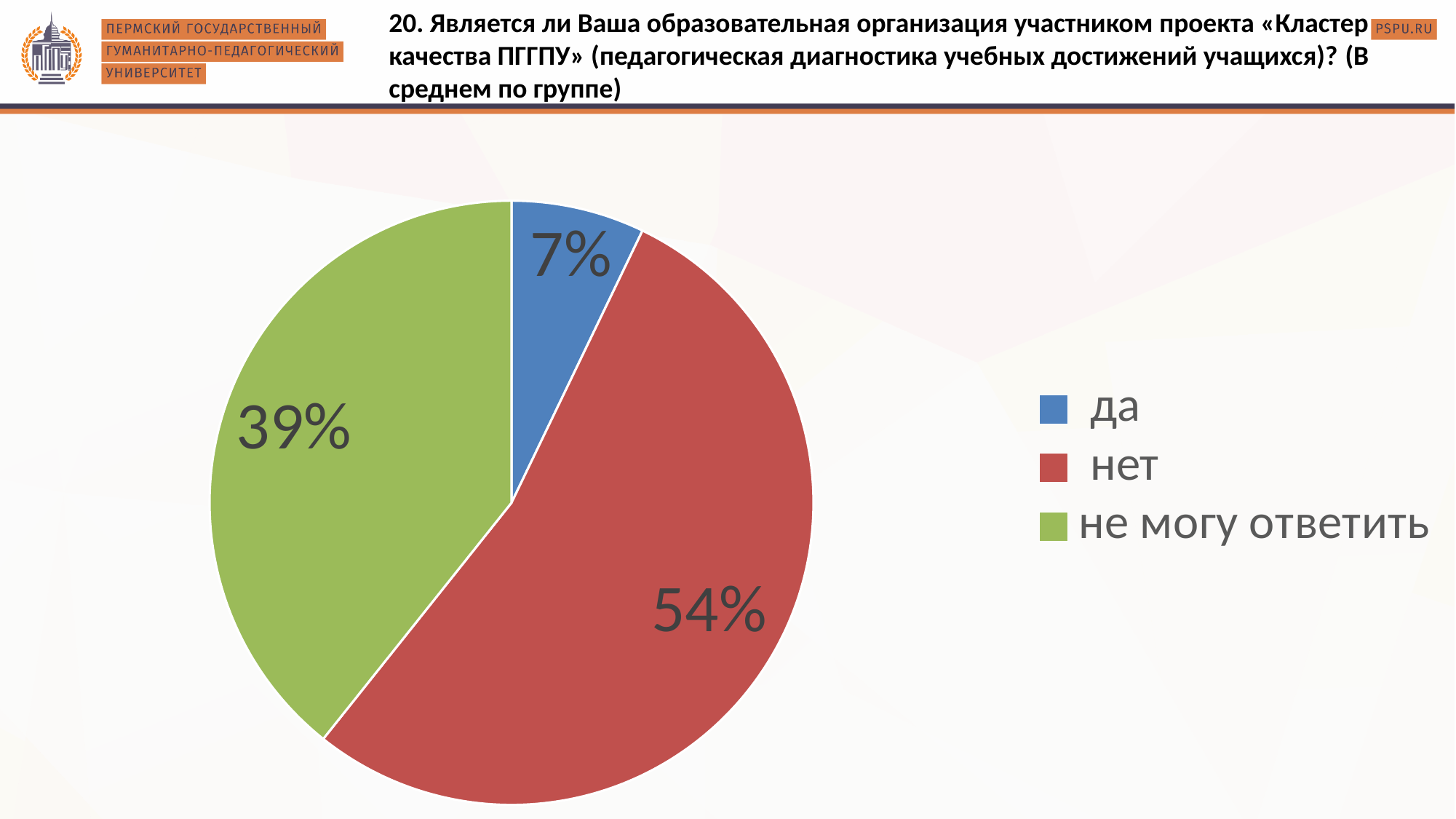
What share of the pie does "не могу ответить" have? 39% Which legend entry is shown in green? не могу ответить Which is larger, the share for "да" or the share for "не могу ответить"? не могу ответить What share of the pie does "нет" have? 54% How many categories does the pie chart have? 3 What colour is the slice for "нет"? red Which category has the largest slice of the pie? нет Which category has the smallest slice of the pie? да What is the difference in percentage points between "нет" and "не могу ответить"? 15 What share of the pie does "да" have? 7% What is the difference in percentage points between "не могу ответить" and "да"? 32 What kind of chart is shown on the slide? pie chart